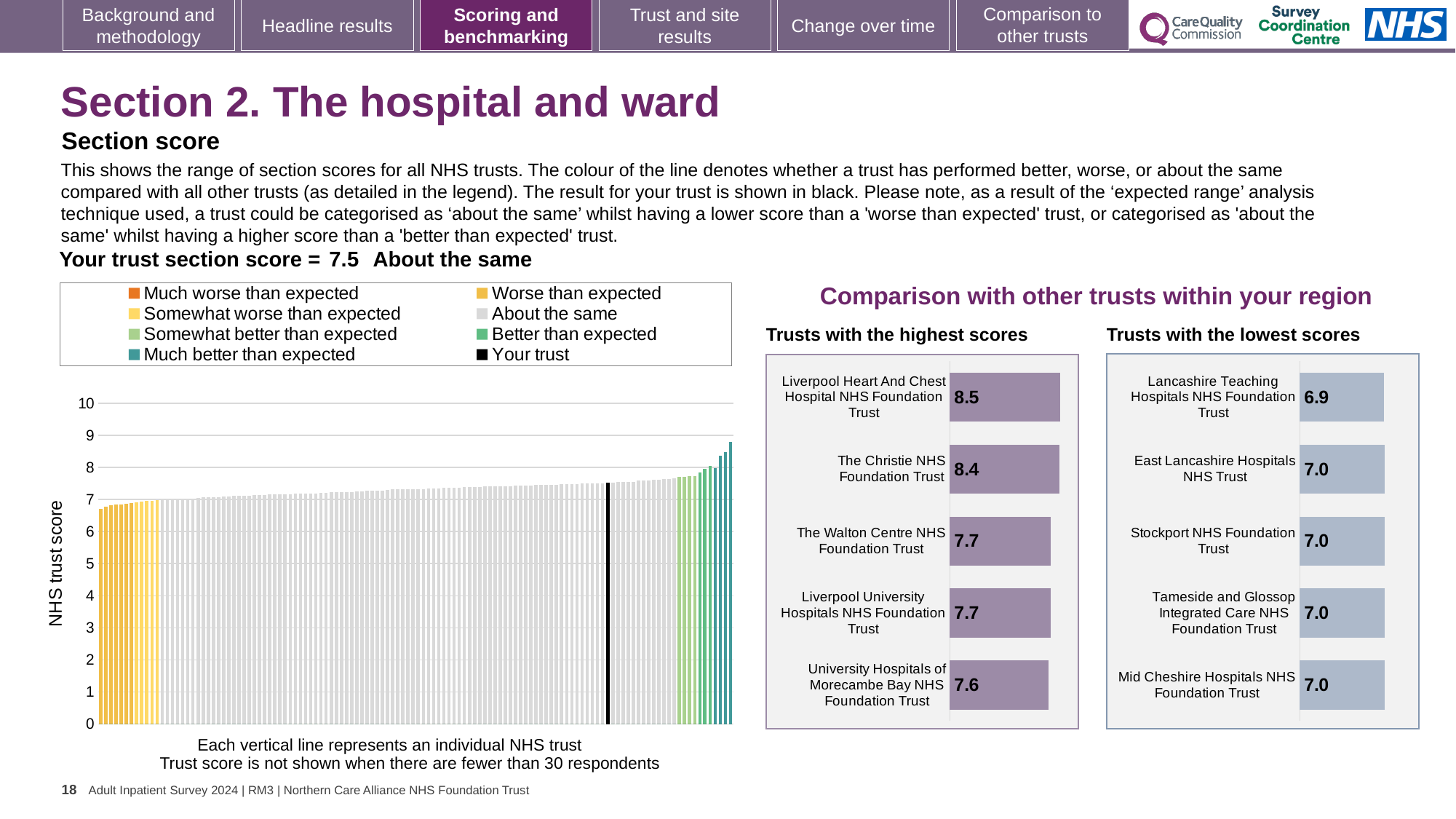
In the 'Trusts with the highest scores' chart, which trust has the lowest score? University Hospitals of Morecambe Bay NHS Foundation Trust In the 'Trusts with the highest scores' chart, what is the difference between the scores of Liverpool Heart And Chest Hospital NHS Foundation Trust and University Hospitals of Morecambe Bay NHS Foundation Trust? 0.9 In the NHS trust score chart on the left, do the trust scores rise or fall from left to right along the x axis? Rise In the 'Trusts with the highest scores' chart, which has the higher score: The Christie NHS Foundation Trust or The Walton Centre NHS Foundation Trust? The Christie NHS Foundation Trust In the 'Trusts with the lowest scores' chart, how many trusts are listed? 5 In the 'Trusts with the lowest scores' chart, what is the score for Lancashire Teaching Hospitals NHS Foundation Trust? 6.9 In the NHS trust score chart on the left, how many entries does the legend list? 8 What kind of chart is the NHS trust score chart on the left of the slide? Bar chart In the 'Trusts with the highest scores' chart, what is the score for The Walton Centre NHS Foundation Trust? 7.7 In the 'Trusts with the lowest scores' chart, which trust has the lowest score? Lancashire Teaching Hospitals NHS Foundation Trust In the 'Trusts with the lowest scores' chart, what is the difference between the scores of Stockport NHS Foundation Trust and Lancashire Teaching Hospitals NHS Foundation Trust? 0.1 In the 'Trusts with the highest scores' chart, what is the score for Liverpool Heart And Chest Hospital NHS Foundation Trust? 8.5